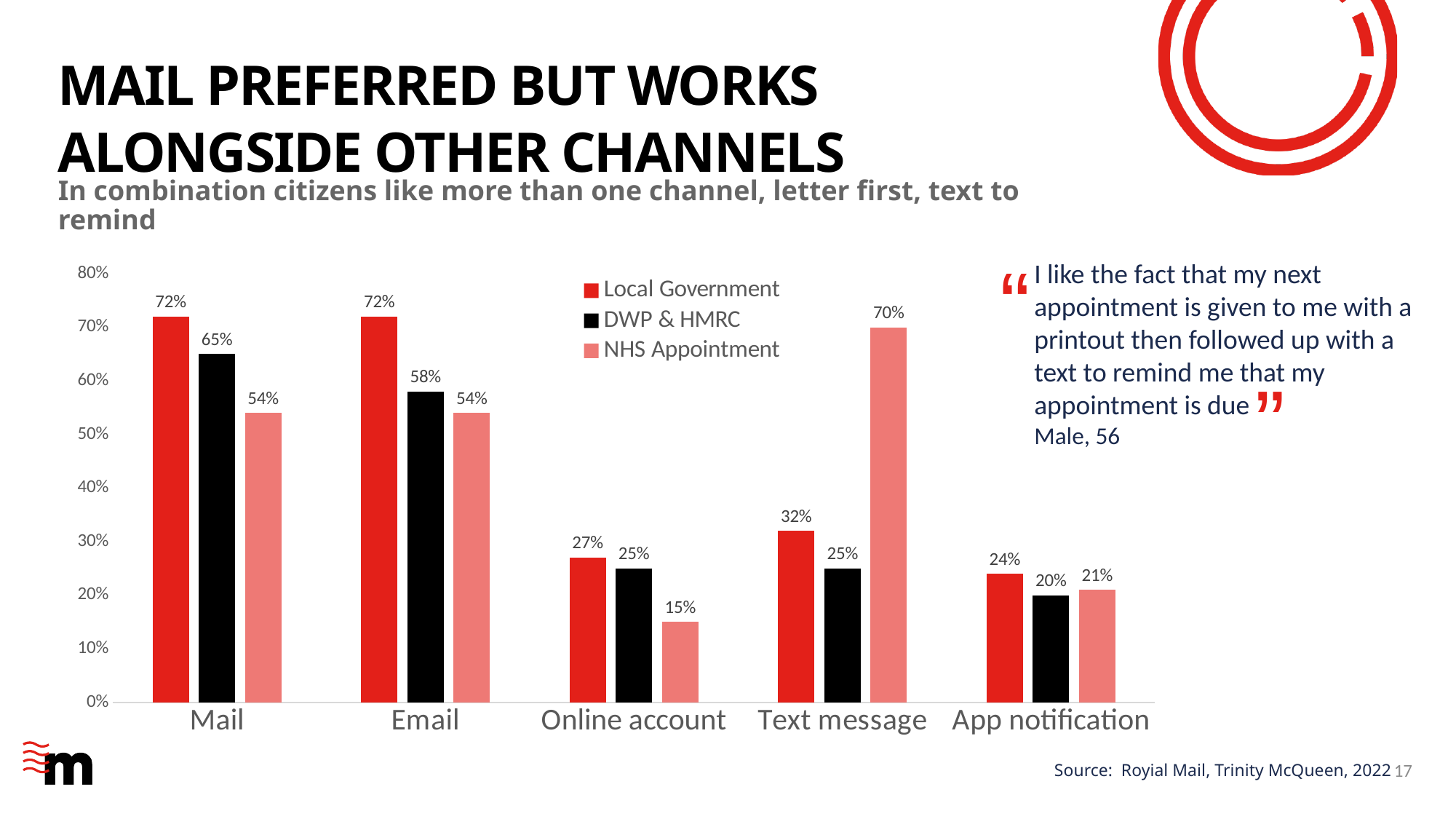
What is the value for DWP & HMRC for Online account? 25% What kind of chart is shown on the slide? Bar chart Which is larger for Email: the DWP & HMRC value or the NHS Appointment value? DWP & HMRC What is the value for Local Government for Mail? 72% Which category has the lowest value for NHS Appointment? Online account Which series is shown in black in the legend? DWP & HMRC How many series does the legend list? 3 What is the difference between the Local Government value for Mail and the Local Government value for App notification? 48% Which category has the highest value for DWP & HMRC? Mail What is the difference between the NHS Appointment value for Text message and the Local Government value for Text message? 38% How many categories are shown on the x axis? 5 What is the value for NHS Appointment for Text message? 70%